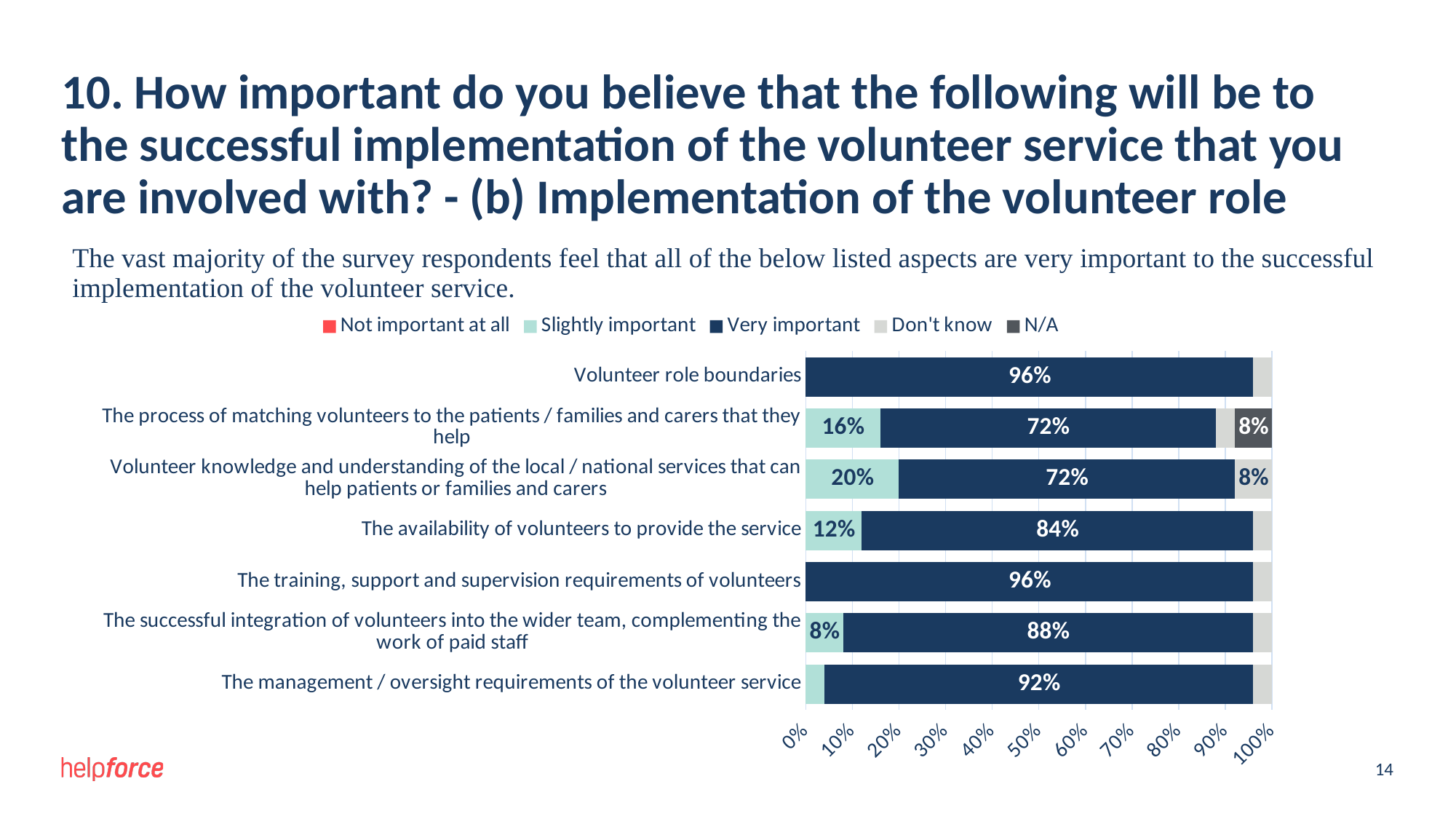
Which category has the lowest 'Very important' share? The process of matching volunteers to the patients / families and carers that they help and Volunteer knowledge and understanding of the local / national services (both 72%) Which legend entry is shown in red? Not important at all Which has a larger 'Slightly important' value: 'The process of matching volunteers to the patients / families and carers that they help' or 'The availability of volunteers to provide the service'? The process of matching volunteers to the patients / families and carers that they help What is the 'Very important' value for 'The availability of volunteers to provide the service'? 84% How many series does the legend list? 5 What is the 'Slightly important' value for 'Volunteer knowledge and understanding of the local / national services that can help patients or families and carers'? 20% What is the difference between the 'Very important' values for 'The successful integration of volunteers into the wider team' and 'The availability of volunteers to provide the service'? 4% How many categories (aspects) are plotted in the chart? 7 What percentage of respondents rated 'Volunteer role boundaries' as very important? 96% What kind of chart is shown on the slide? Stacked bar chart What is the N/A value for 'The process of matching volunteers to the patients / families and carers that they help'? 8% What is the 'Very important' value for 'The management / oversight requirements of the volunteer service'? 92%